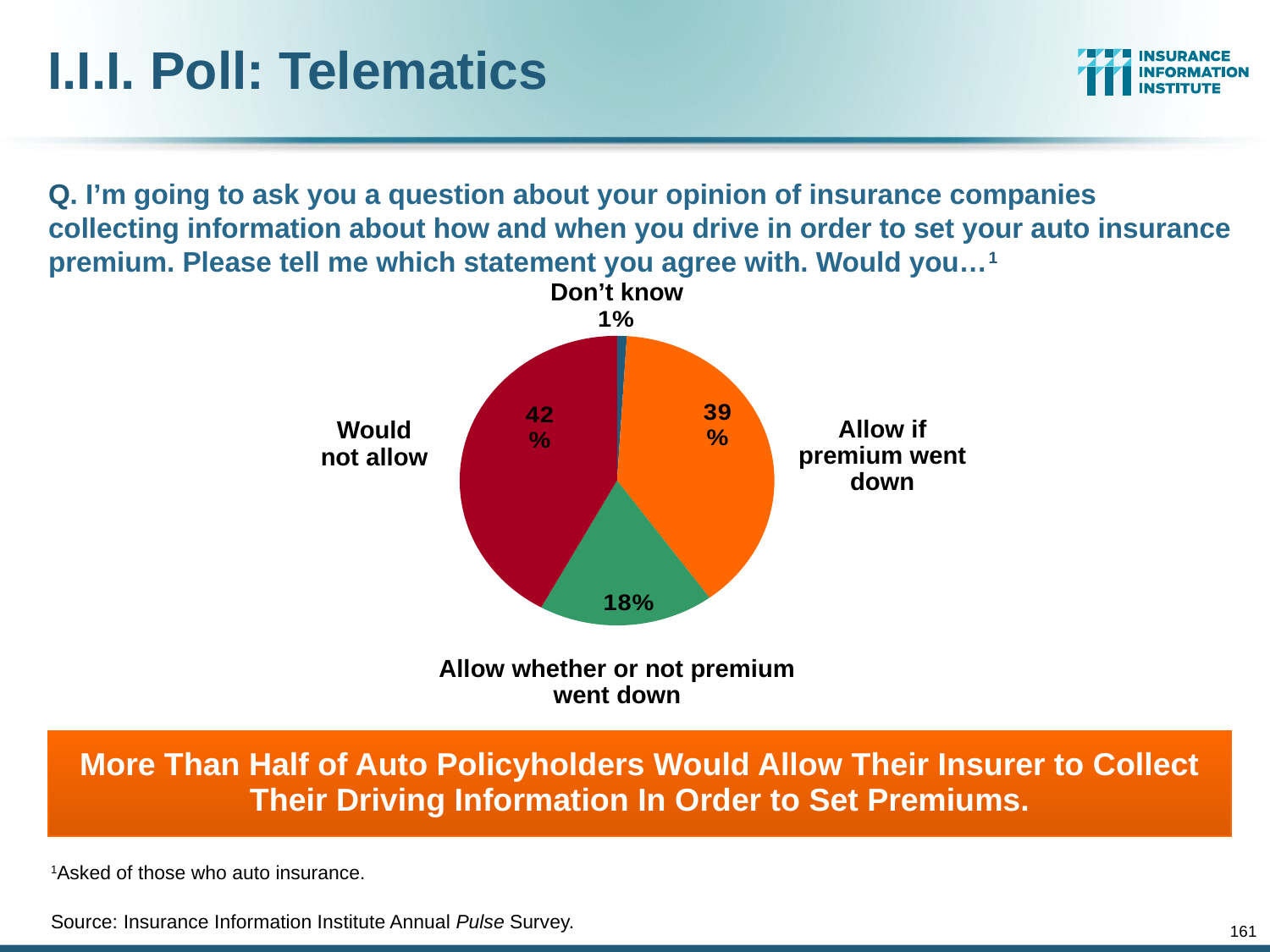
How many slices does the pie chart have? 4 What share of respondents said they would not allow insurers to collect driving information? 42% What percentage of respondents would allow it whether or not their premium went down? 18% What colour is the slice for "Allow whether or not premium went down"? green What is the difference in percentage points between "Would not allow" and "Allow if premium went down"? 3 What kind of chart is shown on the slide? pie chart What percentage of respondents would allow it if their premium went down? 39% What is the combined percentage of respondents who would allow collection, either if the premium went down or whether or not it went down? 57% What percentage of respondents answered "Don't know"? 1% Which response has the smallest share of the pie? Don't know Which response has the largest share of the pie? Would not allow Which is larger: the share for "Allow if premium went down" or the share for "Allow whether or not premium went down"? Allow if premium went down